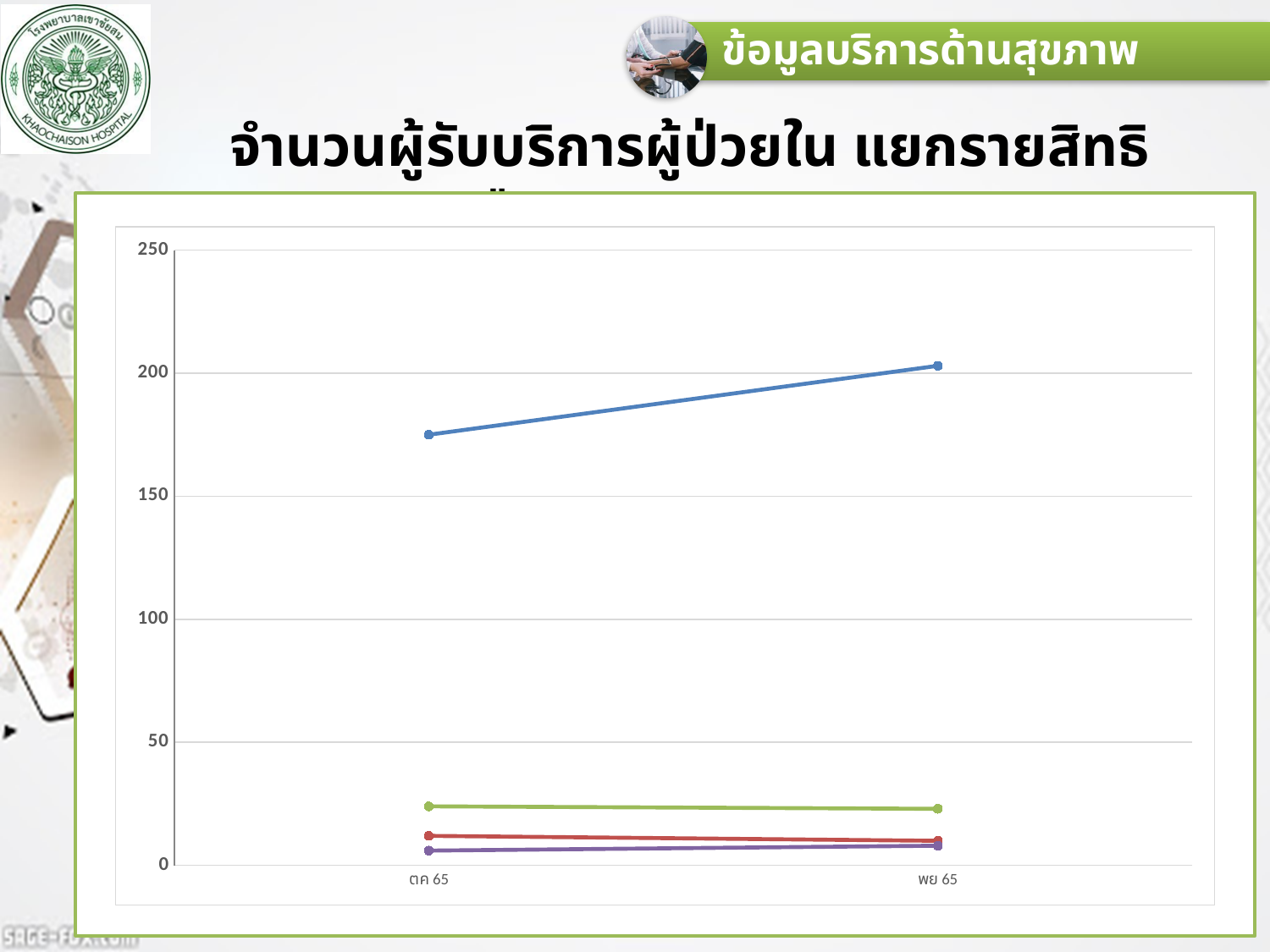
Which coloured line has the lowest value at ตค 65? the purple line Which line has the highest values on the chart, the blue line or the green line? the blue line What is the highest value shown on the y axis of the chart? 250 Is the value of the green line at ตค 65 greater or less than 50? less Does the blue line rise or fall from ตค 65 to พย 65? rise Is the value of the red line at พย 65 greater or less than 50? less Which coloured line has the highest value at พย 65? the blue line What kind of chart is shown on the slide? line chart How many categories are shown on the x axis of the chart? 2 Is the value of the blue line at ตค 65 greater or less than 150? greater What are the two x-axis labels on the chart? ตค 65 and พย 65